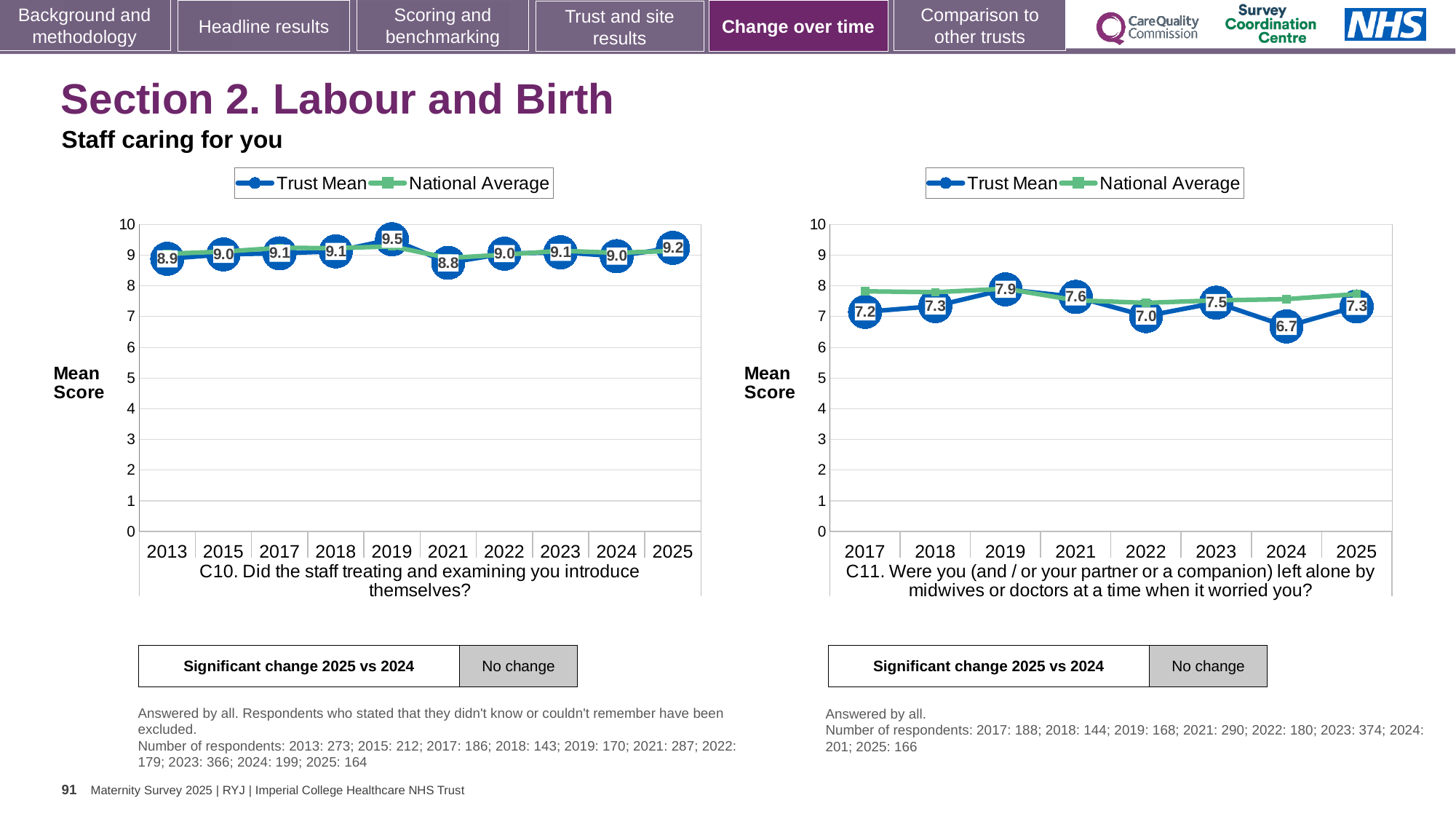
In the C11 chart, is the National Average value for 2017 greater or less than 7? greater In the C11 chart, is the Trust Mean score for 2025 or 2021 larger? 2021 In the C10 chart, what is the Trust Mean score for 2021? 8.8 In the C10 chart, which year has the highest Trust Mean score? 2019 In the C11 chart, which year has the highest Trust Mean score? 2019 How many years are shown on the x axis of the C11 chart? 8 What type of chart is the C10 chart? Line chart In the C10 chart, what is the difference between the Trust Mean scores for 2019 and 2021? 0.7 In the C10 chart, which year has the lowest Trust Mean score? 2021 In the C11 chart, which year has the lowest Trust Mean score? 2024 In the C10 chart, what is the Trust Mean score for 2019? 9.5 In the C11 chart, what is the Trust Mean score for 2024? 6.7